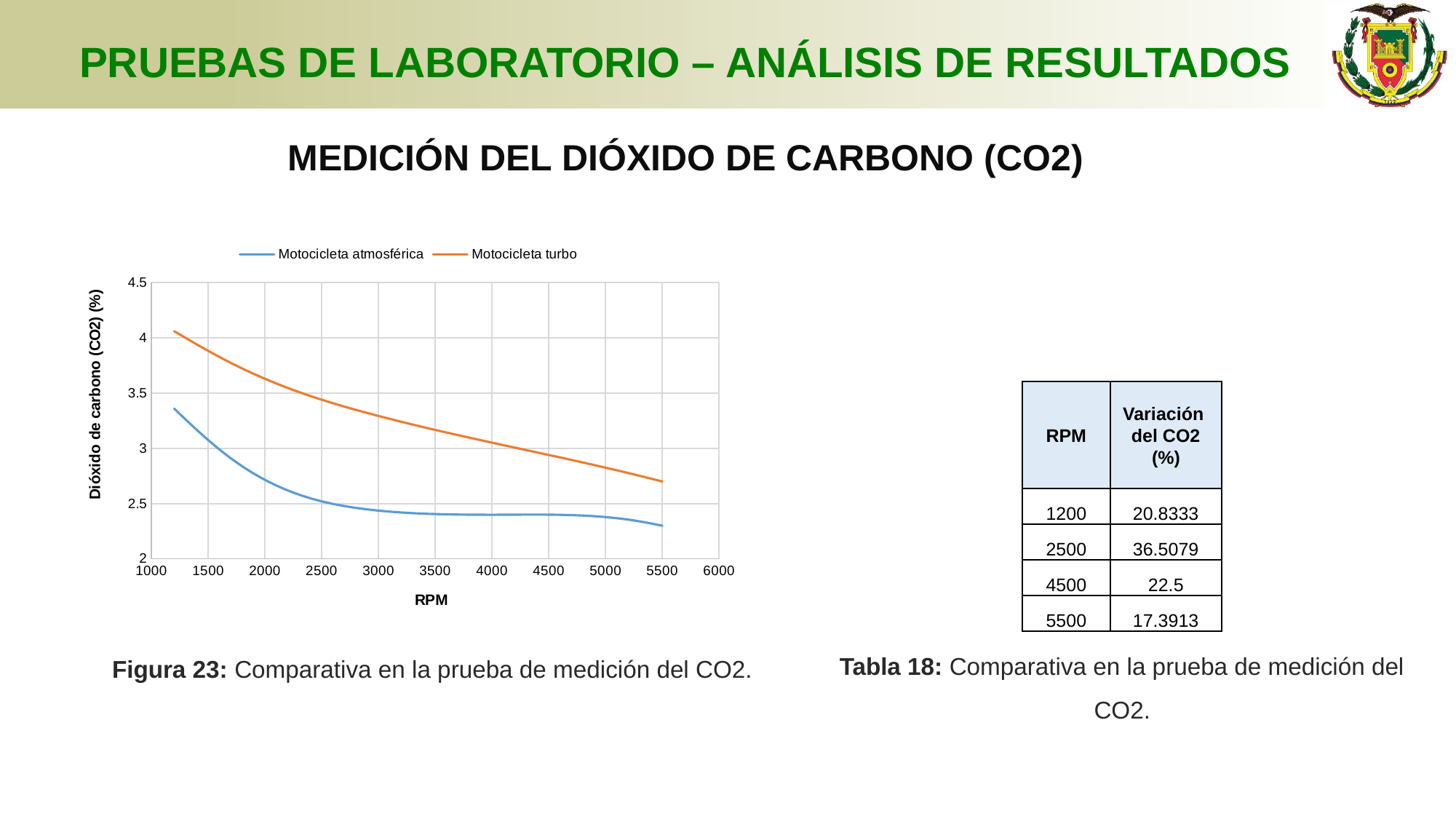
Do the values for Motocicleta atmosférica rise or fall as RPM increases? fall Is the value for Motocicleta turbo at 1200 RPM greater or less than 3.5? greater What are the two series named in the chart legend? Motocicleta atmosférica and Motocicleta turbo Is the value for Motocicleta atmosférica at 3000 RPM greater or less than 3? less Do the values for Motocicleta turbo rise or fall as RPM increases? fall How many series does the legend of the chart list? 2 What is the label of the vertical axis of the chart? Dióxido de carbono (CO2) (%) What kind of chart is shown in Figura 23? line chart Which series has the higher CO2 value at 1200 RPM, Motocicleta atmosférica or Motocicleta turbo? Motocicleta turbo Is the value for Motocicleta turbo at 5500 RPM greater or less than 2.5? greater Which series has the higher CO2 value at 5500 RPM, Motocicleta atmosférica or Motocicleta turbo? Motocicleta turbo